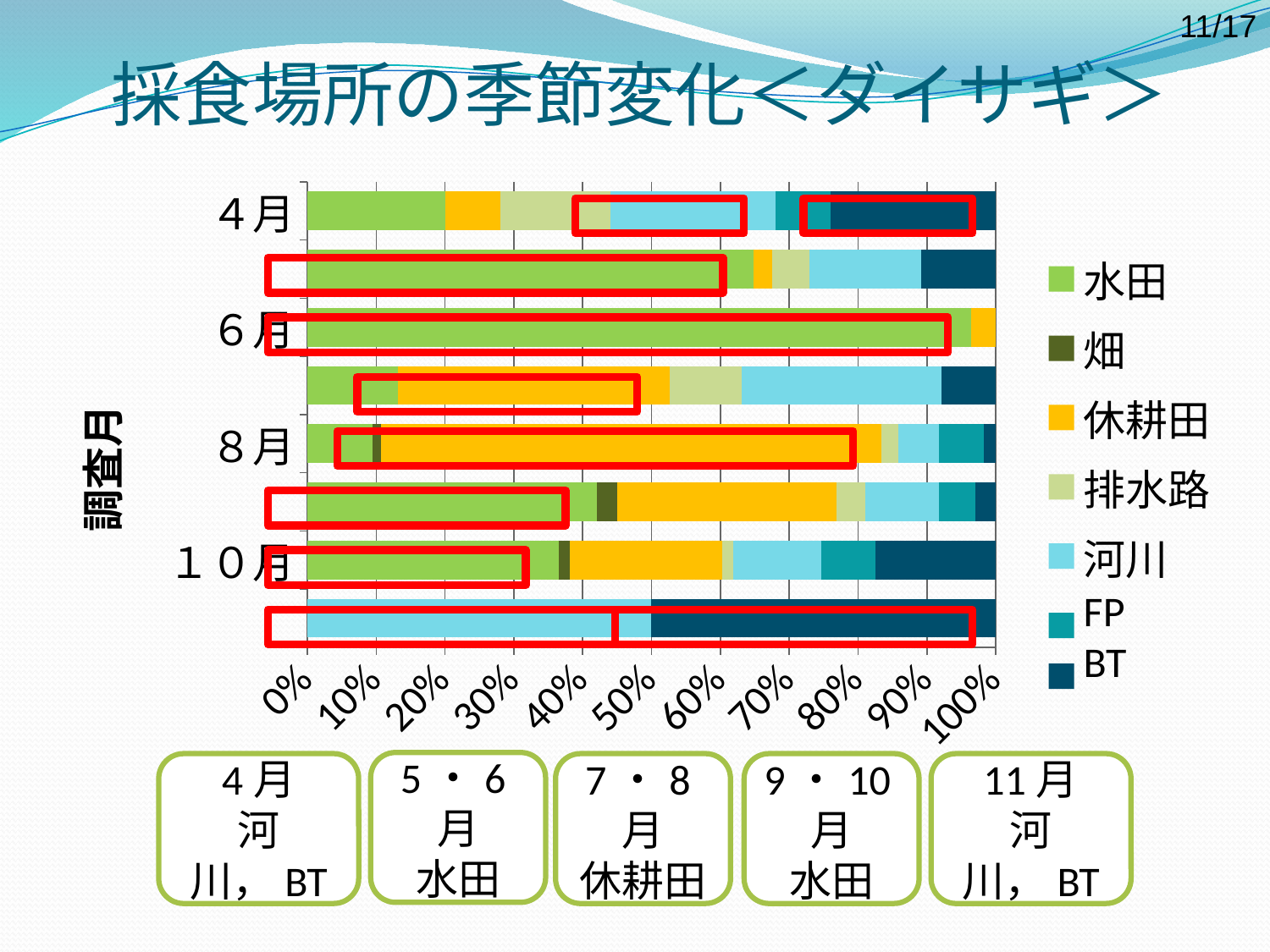
What is the label on the vertical axis of the chart? 調査月 In 8月, which is larger, the 休耕田 share or the 水田 share? 休耕田 In 6月, which is larger, the 水田 share or the 休耕田 share? 水田 Which month has the largest 水田 share? 6月 Is the 休耕田 share for 8月 greater or less than 50%? greater Is the 水田 share for 6月 greater or less than 80%? greater How many series does the legend list? 7 What kind of chart is shown on the slide? bar chart What is the title of the slide containing the chart? 採食場所の季節変化＜ダイサギ＞ Is the 水田 share for 4月 greater or less than 30%? less How many bars (months) are plotted in the chart? 8